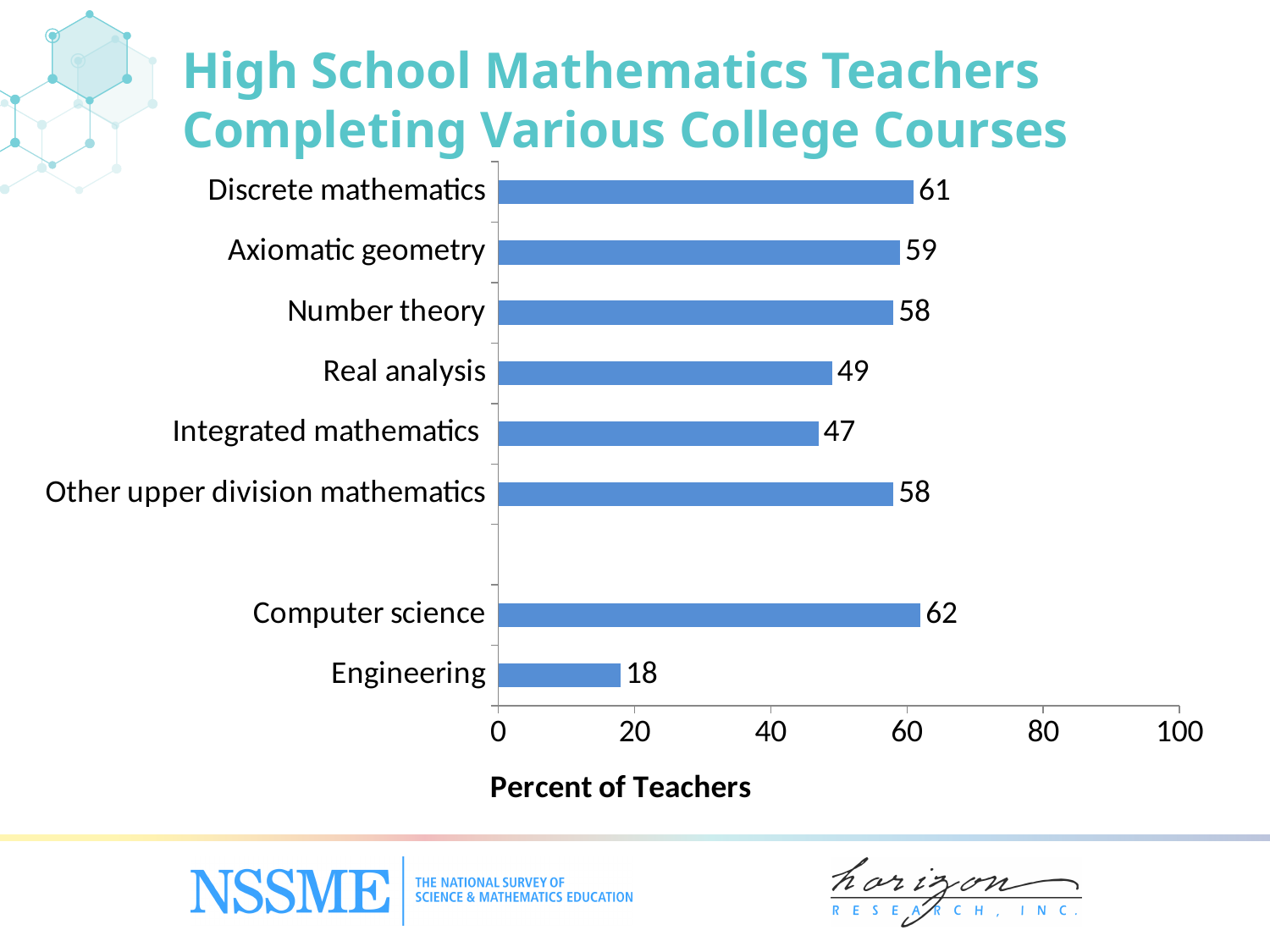
Is the value for Integrated mathematics greater or less than 60? less Which course has the lowest percent of teachers? Engineering What percent of teachers completed Discrete mathematics? 61 What kind of chart is shown on the slide? bar chart Which course has the highest percent of teachers? Computer science What is the difference between the values for Discrete mathematics and Integrated mathematics? 14 How many courses are shown in the chart? 8 What is the value for Real analysis? 49 What is the value for Engineering? 18 What is the difference between the values for Computer science and Engineering? 44 Which is larger, the value for Axiomatic geometry or the value for Real analysis? Axiomatic geometry What is the label of the horizontal axis? Percent of Teachers